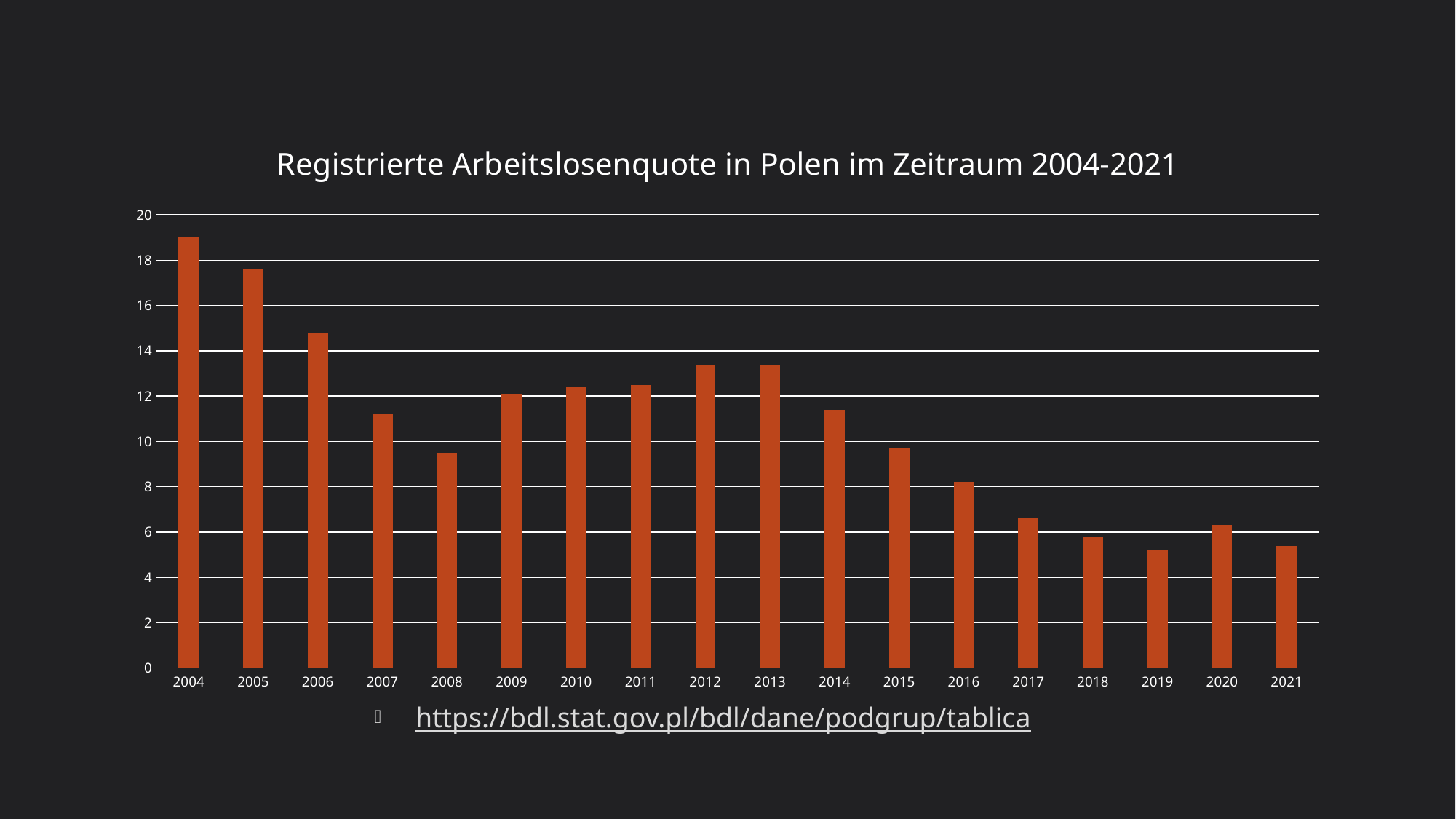
Which year has the highest bar? 2004 Is the value for 2004 greater or less than 18? greater Is the value for 2019 greater or less than 6? less Is the value for 2008 greater or less than 10? less What is the title of the chart? Registrierte Arbeitslosenquote in Polen im Zeitraum 2004-2021 Overall, do the values rise or fall from 2004 to 2021? fall How many years are plotted on the x axis? 18 What kind of chart is shown on the slide? bar chart Which is larger, the value for 2005 or the value for 2006? 2005 Which is larger, the value for 2008 or the value for 2009? 2009